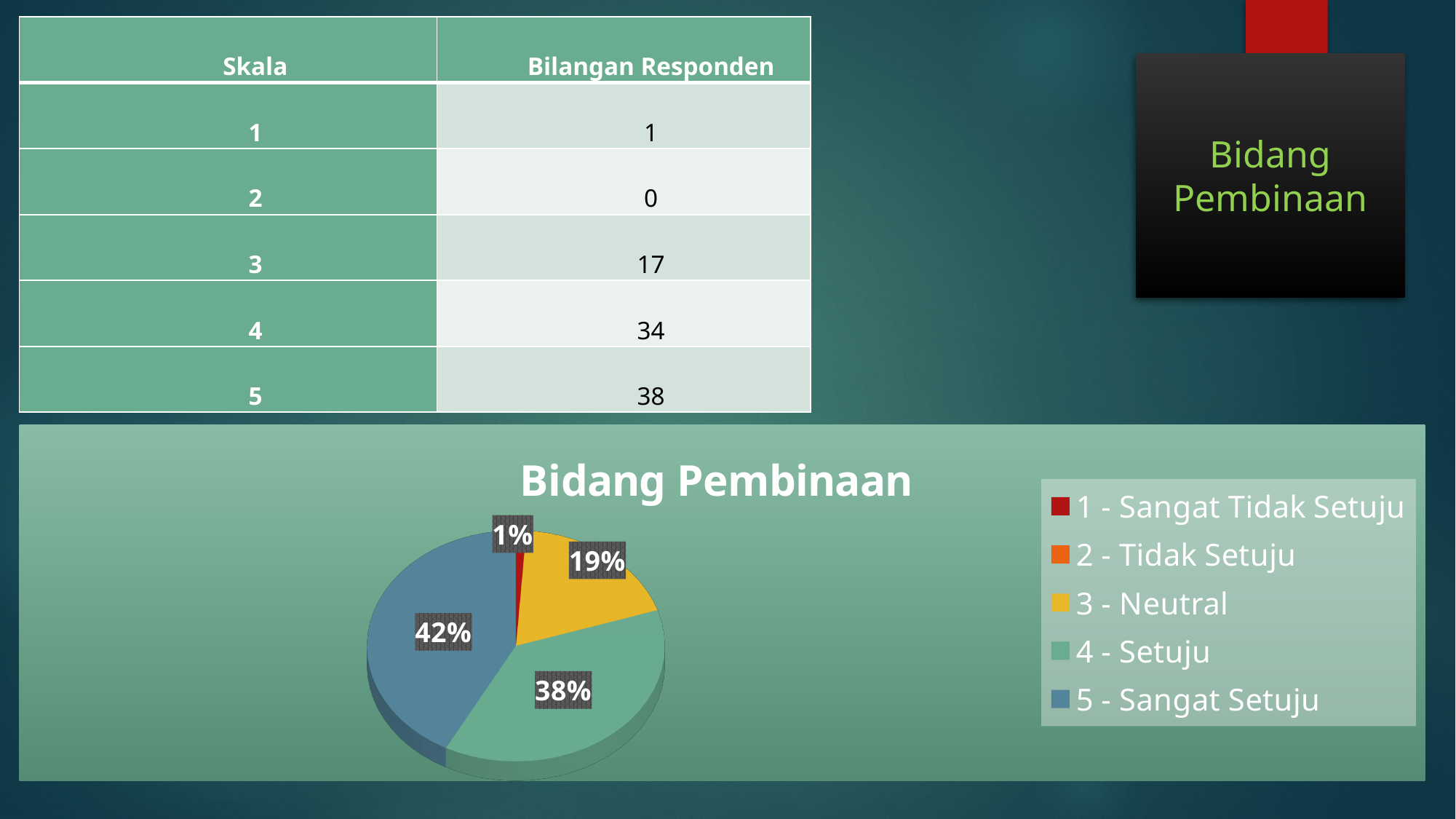
What percentage does the "1 - Sangat Tidak Setuju" slice show in the pie chart? 1% In the pie chart, which slice is larger: "3 - Neutral" or "4 - Setuju"? 4 - Setuju What is the title of the pie chart? Bidang Pembinaan Which legend entry in the pie chart is shown in yellow? 3 - Neutral Which category has the largest slice in the pie chart? 5 - Sangat Setuju What percentage does the "5 - Sangat Setuju" slice show in the pie chart? 42% What percentage does the "4 - Setuju" slice show in the pie chart? 38% What is the difference in percentage points between the "5 - Sangat Setuju" and "4 - Setuju" slices in the pie chart? 4 How many entries does the legend of the pie chart list? 5 What percentage does the "3 - Neutral" slice show in the pie chart? 19% Which labelled slice in the pie chart is the smallest? 1 - Sangat Tidak Setuju What type of chart is shown under the title "Bidang Pembinaan"? Pie chart